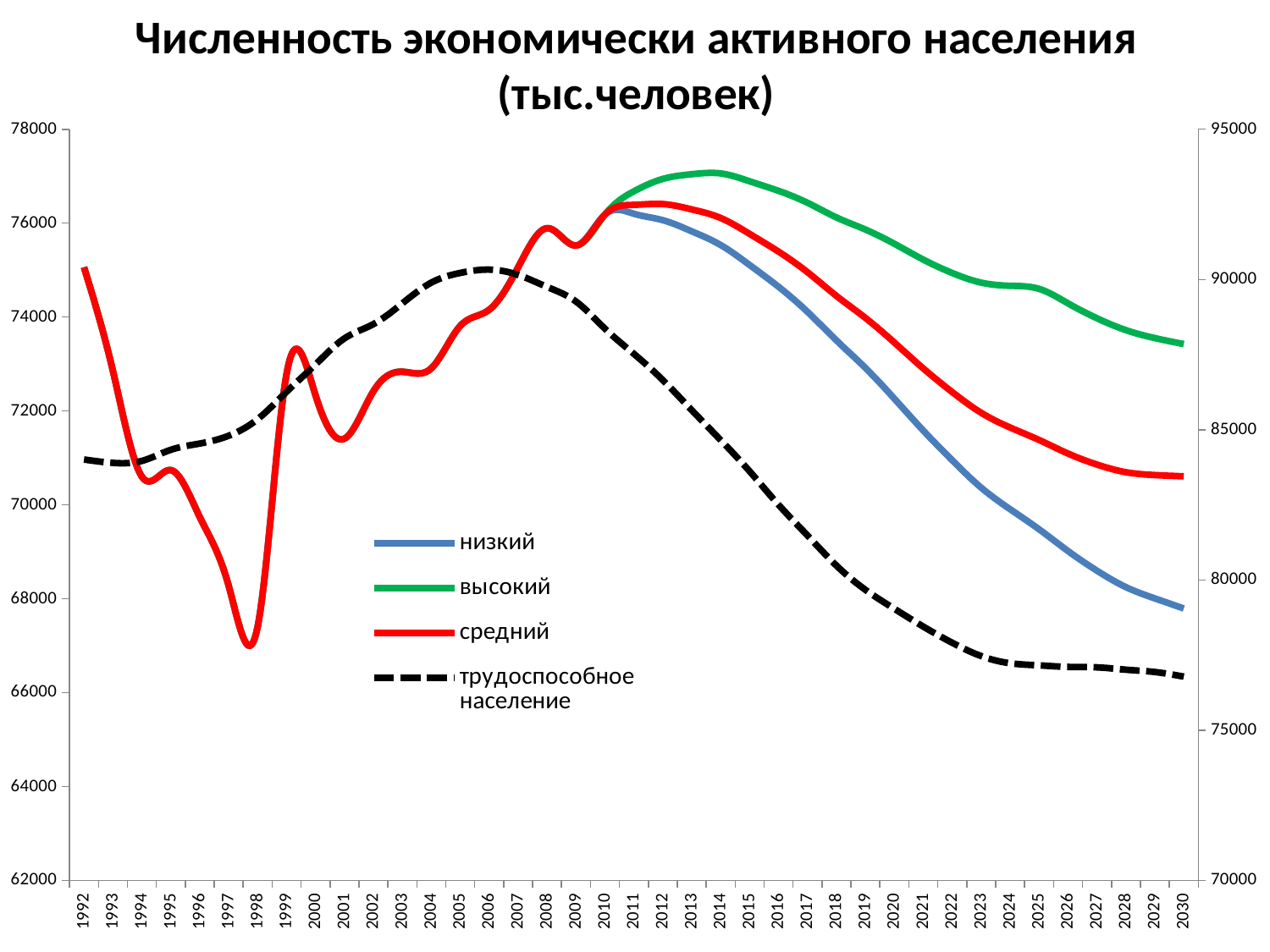
Which series is drawn with a dashed line? трудоспособное население What is the title of the chart? Численность экономически активного населения (тыс.человек) In 2030, which is larger: the value for высокий or the value for низкий? высокий Among the series низкий, высокий and средний, which is the lowest in 2030? низкий Does the средний series rise or fall from 1992 to 1994? fall How many series does the legend list? 4 What kind of chart is shown on the slide? line chart On the left axis, is the value of the средний series in 1998 greater or less than 68000? less What is the first year shown on the x axis? 1992 Does the высокий series rise or fall from 2014 to 2030? fall For the средний series, which year has the larger value: 1998 or 1999? 1999